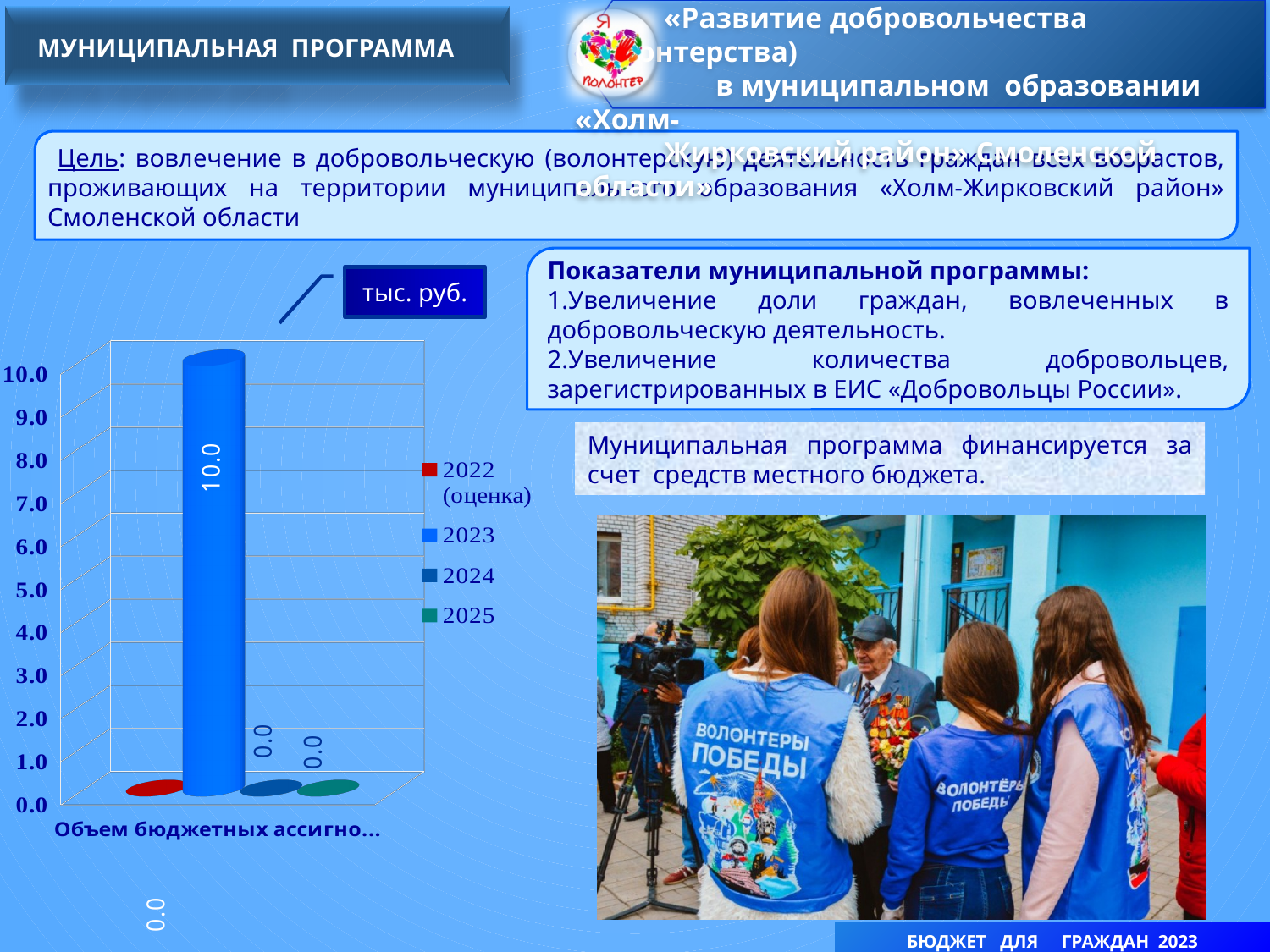
What is the first legend entry of the chart? 2022 (оценка) Which year has the highest value in the chart? 2023 What is the highest value shown on the chart's vertical axis? 10.0 Is the value for 2023 greater or less than 5.0? greater What kind of chart is shown on the slide? bar chart What is the value for 2025 in the chart? 0.0 What is the value for 2023 in the chart? 10.0 What unit of measurement is indicated for the chart? тыс. руб. What is the difference between the values for 2023 and 2024? 10.0 How many series does the chart legend list? 4 What is the value for 2024 in the chart? 0.0 Which is larger, the value for 2023 or the value for 2025? 2023